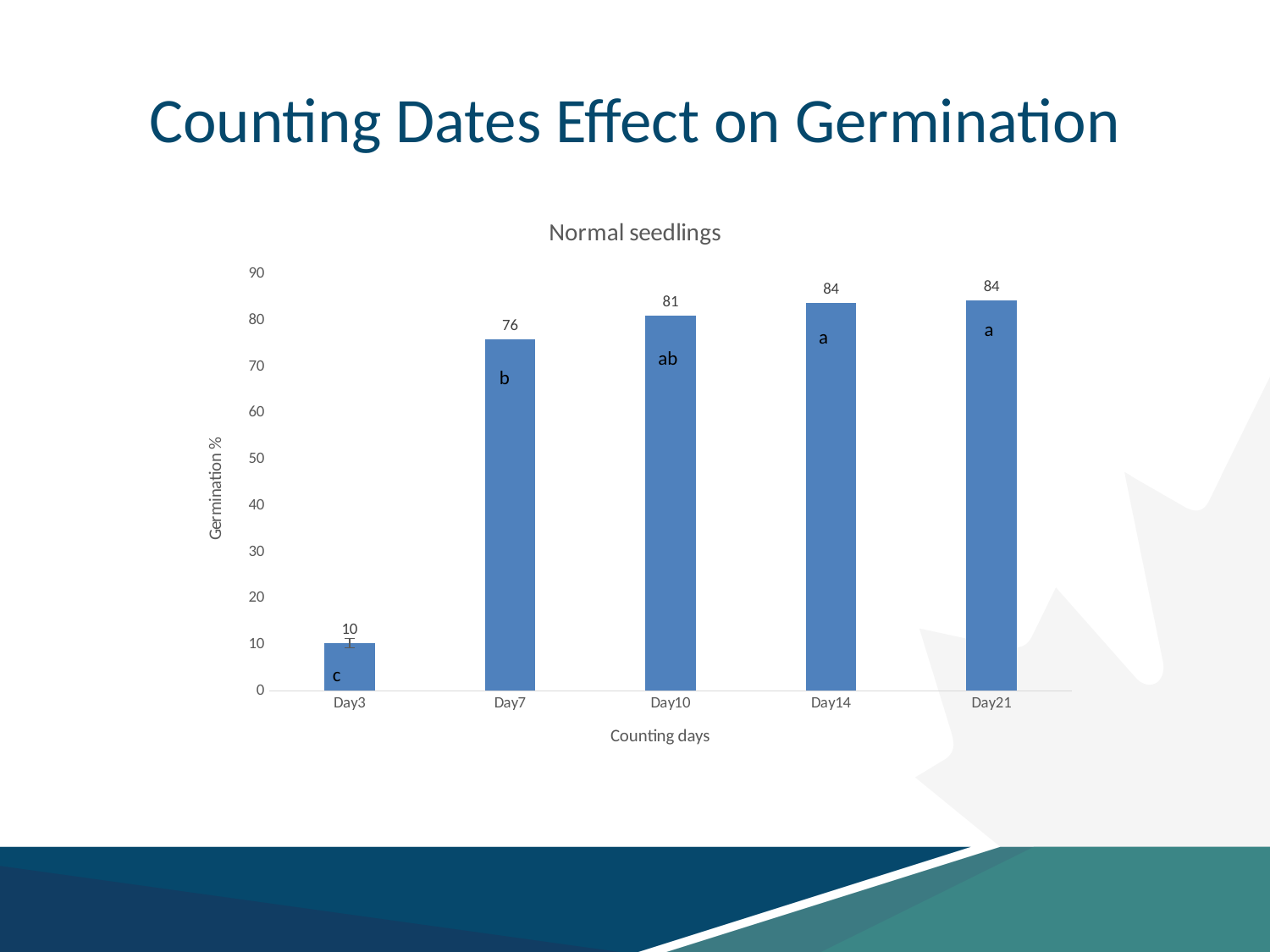
What is the germination % for Day3? 10 How many counting days are shown on the x axis? 5 What is the germination % for Day7? 76 What is the difference in germination % between Day7 and Day3? 66 Is the value for Day7 greater or less than 70? greater Do the germination % values rise or fall from Day3 to Day21? Rise What kind of chart is shown on the slide? Bar chart Which counting day has the lowest germination %? Day3 What is the title of the chart? Normal seedlings Which has a higher germination %, Day7 or Day10? Day10 What is the germination % for Day10? 81 What is the difference in germination % between Day14 and Day10? 3